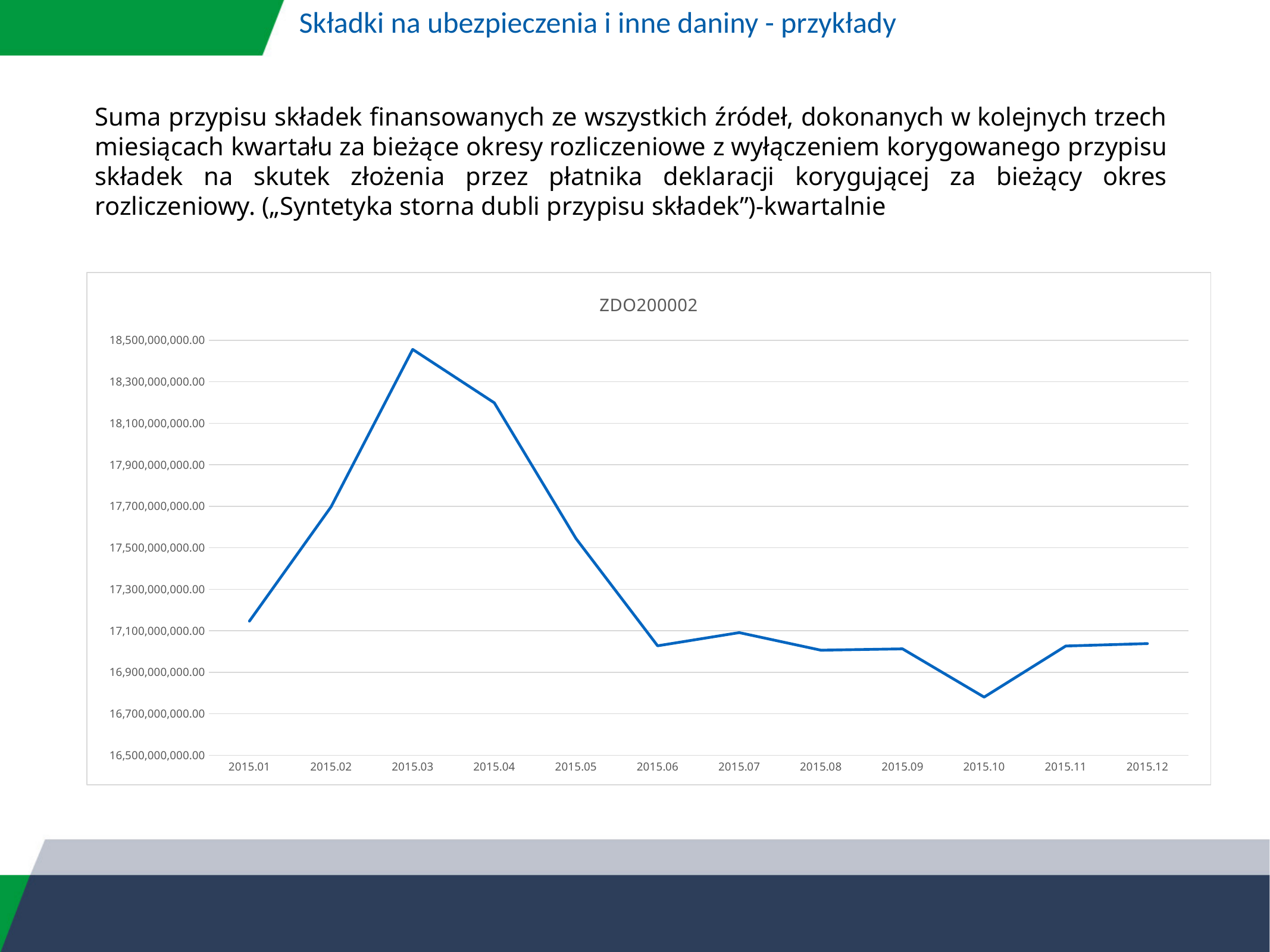
Is the value for 2015.10 greater or less than 16,900,000,000.00? less What is the title of the chart? ZDO200002 Is the value for 2015.03 greater or less than 18,300,000,000.00? greater Do the values rise or fall from 2015.03 to 2015.06? fall Is the value for 2015.05 greater or less than 17,700,000,000.00? less Which is larger, the value for 2015.04 or the value for 2015.05? 2015.04 Which is larger, the value for 2015.02 or the value for 2015.01? 2015.02 Which month has the highest value on the chart? 2015.03 Which month has the lowest value on the chart? 2015.10 What kind of chart is shown on the slide? line chart How many data points are plotted on the chart? 12